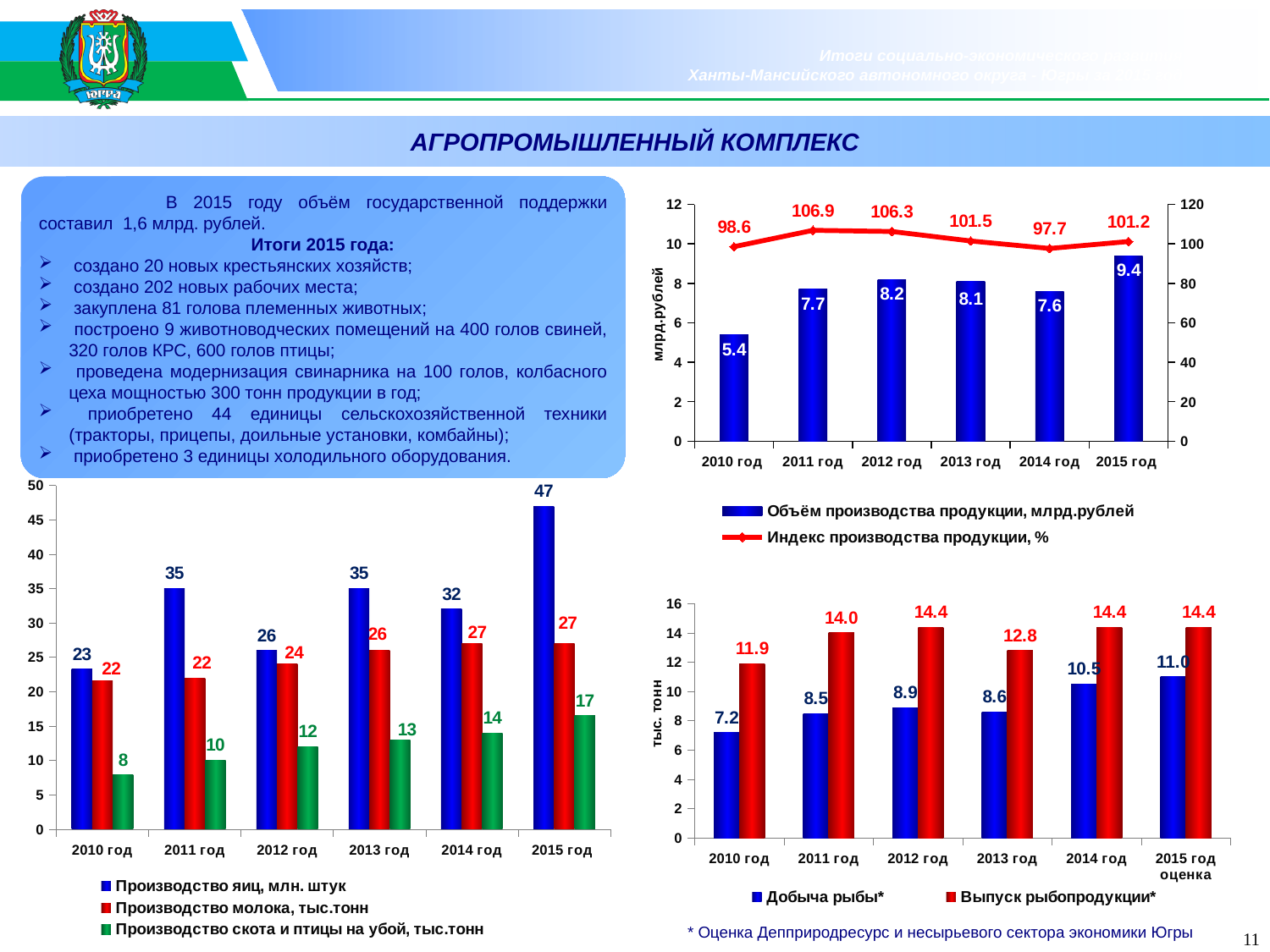
In the top-right chart, which year has the lowest 'Объём производства продукции, млрд.рублей'? 2010 год In the bottom-left chart, how many years are shown on the x axis? 6 What kind of chart is the bottom-right chart? bar chart In the bottom-right chart, which is larger for 2013 год: 'Добыча рыбы*' or 'Выпуск рыбопродукции*'? Выпуск рыбопродукции* In the bottom-left chart, which year has the highest 'Производство яиц, млн. штук'? 2015 год In the bottom-left chart, what is the value of 'Производство скота и птицы на убой, тыс.тонн' for 2010 год? 8 In the top-right chart, what is the value of 'Индекс производства продукции, %' for 2011 год? 106.9 In the top-right chart, what is the value of 'Объём производства продукции, млрд.рублей' for 2015 год? 9.4 In the top-right chart, how many series does the legend list? 2 In the top-right chart, what is the difference between the 'Объём производства продукции' values for 2015 год and 2010 год? 4.0 In the bottom-right chart, what is the value of 'Добыча рыбы*' for 2014 год? 10.5 In the bottom-left chart, what is the value of 'Производство яиц, млн. штук' for 2015 год? 47